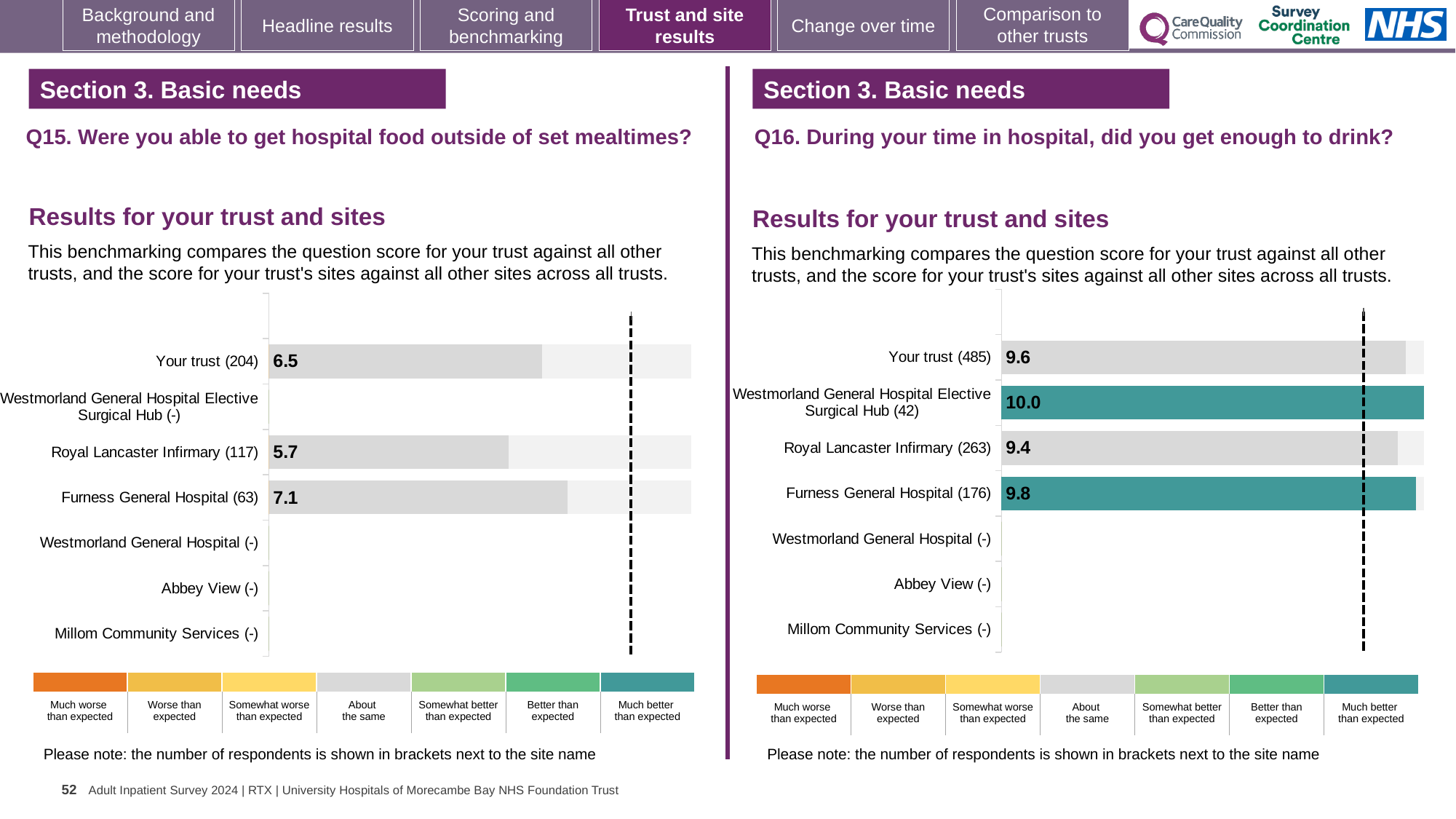
On the Q16 chart (right), which benchmark category does the colour of the Furness General Hospital bar indicate? Much better than expected On the Q15 chart (left), how many respondents are shown for Your trust? 204 On the Q15 chart (left), what is the score for Your trust? 6.5 On the Q16 chart (right), what is the difference between the scores for Westmorland General Hospital Elective Surgical Hub and Your trust? 0.4 On the Q15 chart (left), what is the difference between the scores for Furness General Hospital and Royal Lancaster Infirmary? 1.4 On the Q15 chart (left), what is the score for Royal Lancaster Infirmary? 5.7 On the Q16 chart (right), is the score for Your trust or Royal Lancaster Infirmary larger? Your trust On the Q16 chart (right), which site has the lowest score among those with a plotted bar? Royal Lancaster Infirmary What kind of chart is used on the Q16 (right) side of the slide? Bar chart On the Q15 chart (left), which site has the highest score? Furness General Hospital On the Q16 chart (right), what is the score for Westmorland General Hospital Elective Surgical Hub? 10.0 On the Q16 chart (right), what is the score for Furness General Hospital? 9.8